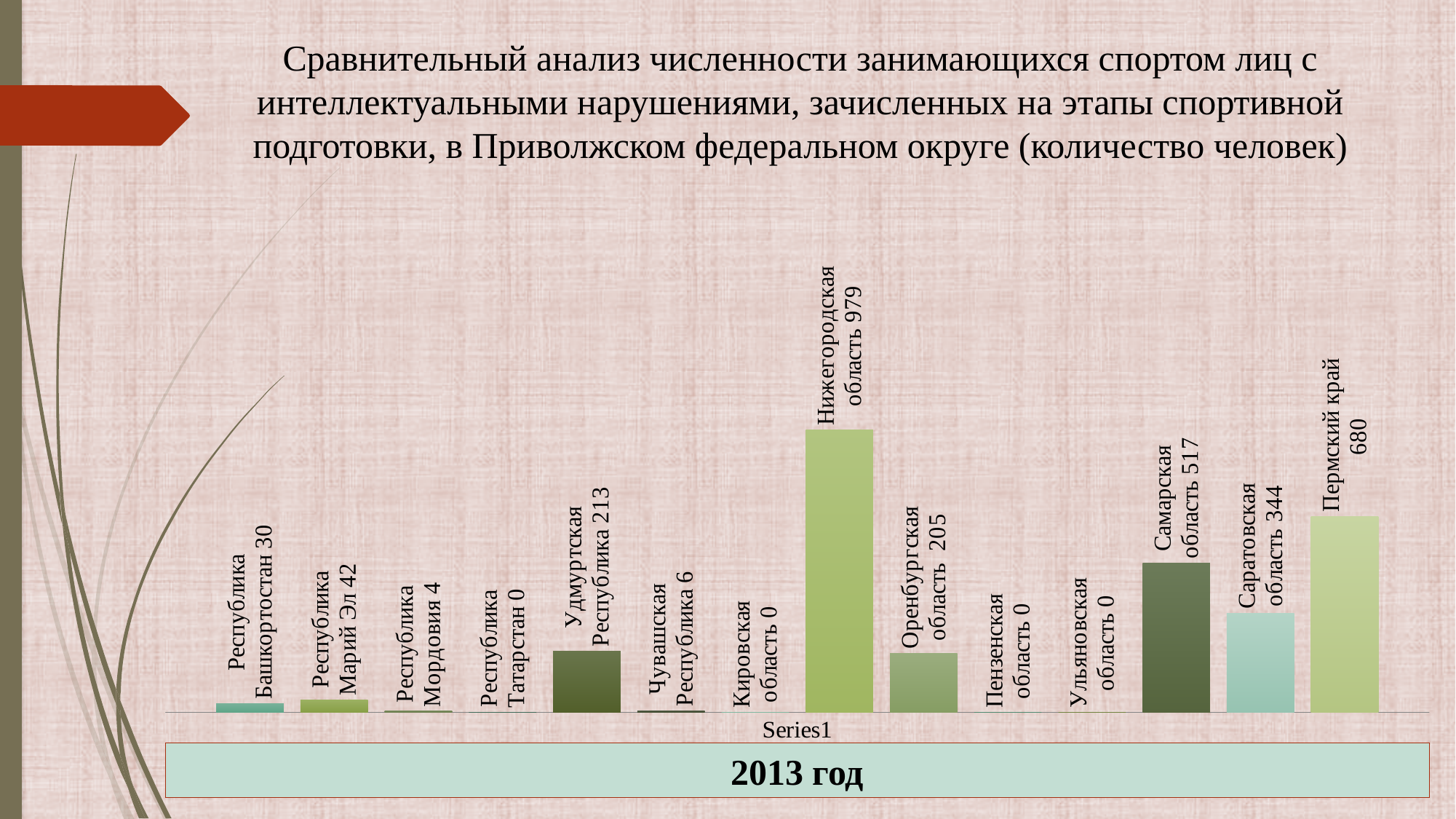
What is the value for Нижегородская область? 979 Which is larger, the value for Республика Марий Эл or the value for Республика Башкортостан? Республика Марий Эл What is the value for Пермский край? 680 How many regions have a value of 0? 4 Which region has the highest value? Нижегородская область How many regions are shown in the chart? 14 What is the difference between the values for Самарская область and Оренбургская область? 312 What is the value for Удмуртская Республика? 213 What kind of chart is shown on the slide? bar chart What is the difference between the values for Нижегородская область and Пермский край? 299 Which year does the chart refer to? 2013 год What is the value for Саратовская область? 344